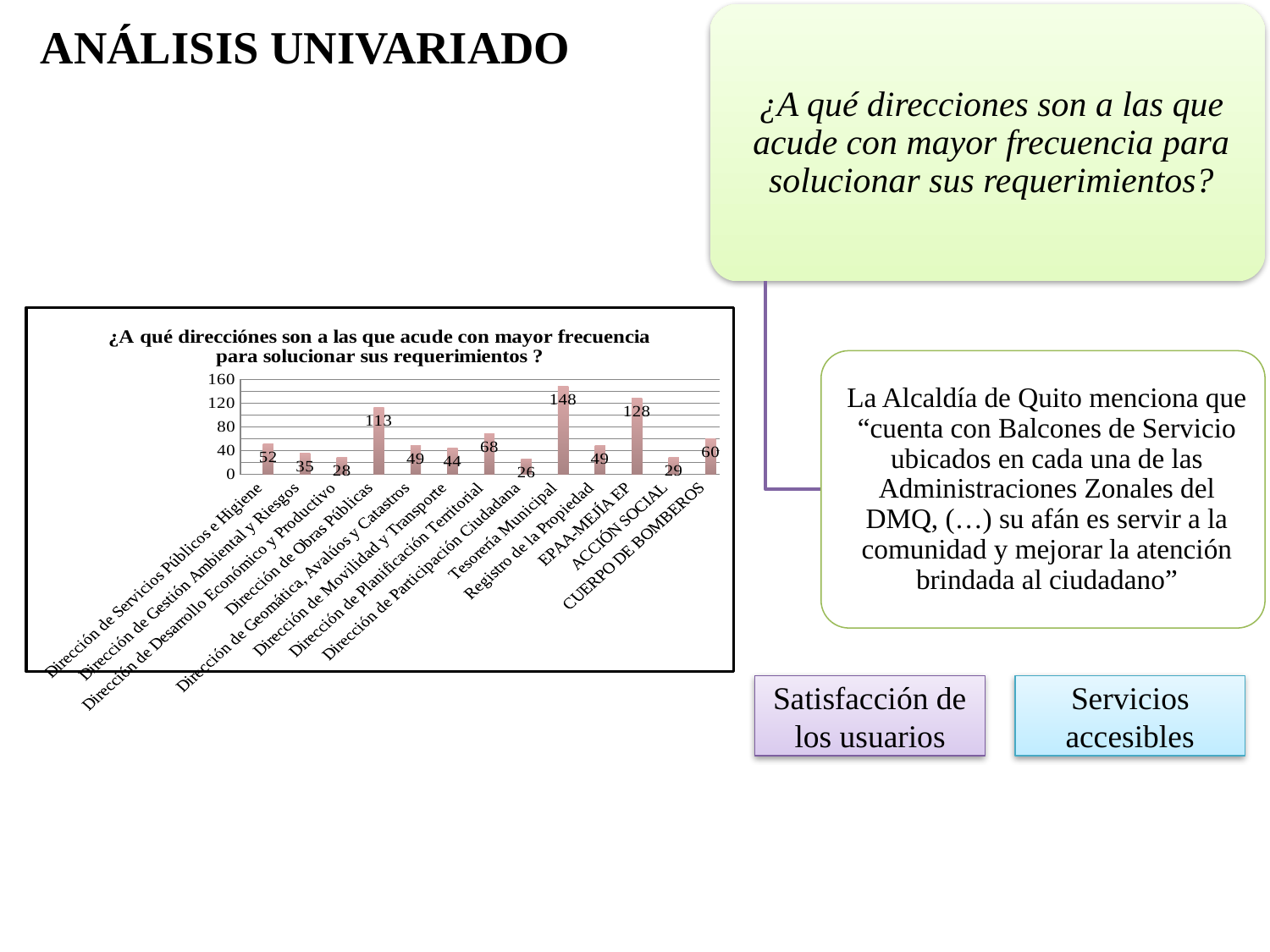
What is the maximum value shown on the chart's vertical axis? 160 How many categories are shown on the x axis of the chart? 13 Which category has the highest value? Tesorería Municipal What kind of chart is shown on the slide? Bar chart What value is shown for CUERPO DE BOMBEROS? 60 What is the difference between the values for Tesorería Municipal and EPAA-MEJÍA EP? 20 What value is shown for Dirección de Planificación Territorial? 68 What is the difference between the values for Dirección de Servicios Públicos e Higiene and Dirección de Gestión Ambiental y Riesgos? 17 What value is shown for Dirección de Obras Públicas? 113 What value is shown for Tesorería Municipal? 148 Which category has the lowest value? Dirección de Participación Ciudadana Which is larger, the value for Dirección de Obras Públicas or the value for EPAA-MEJÍA EP? EPAA-MEJÍA EP